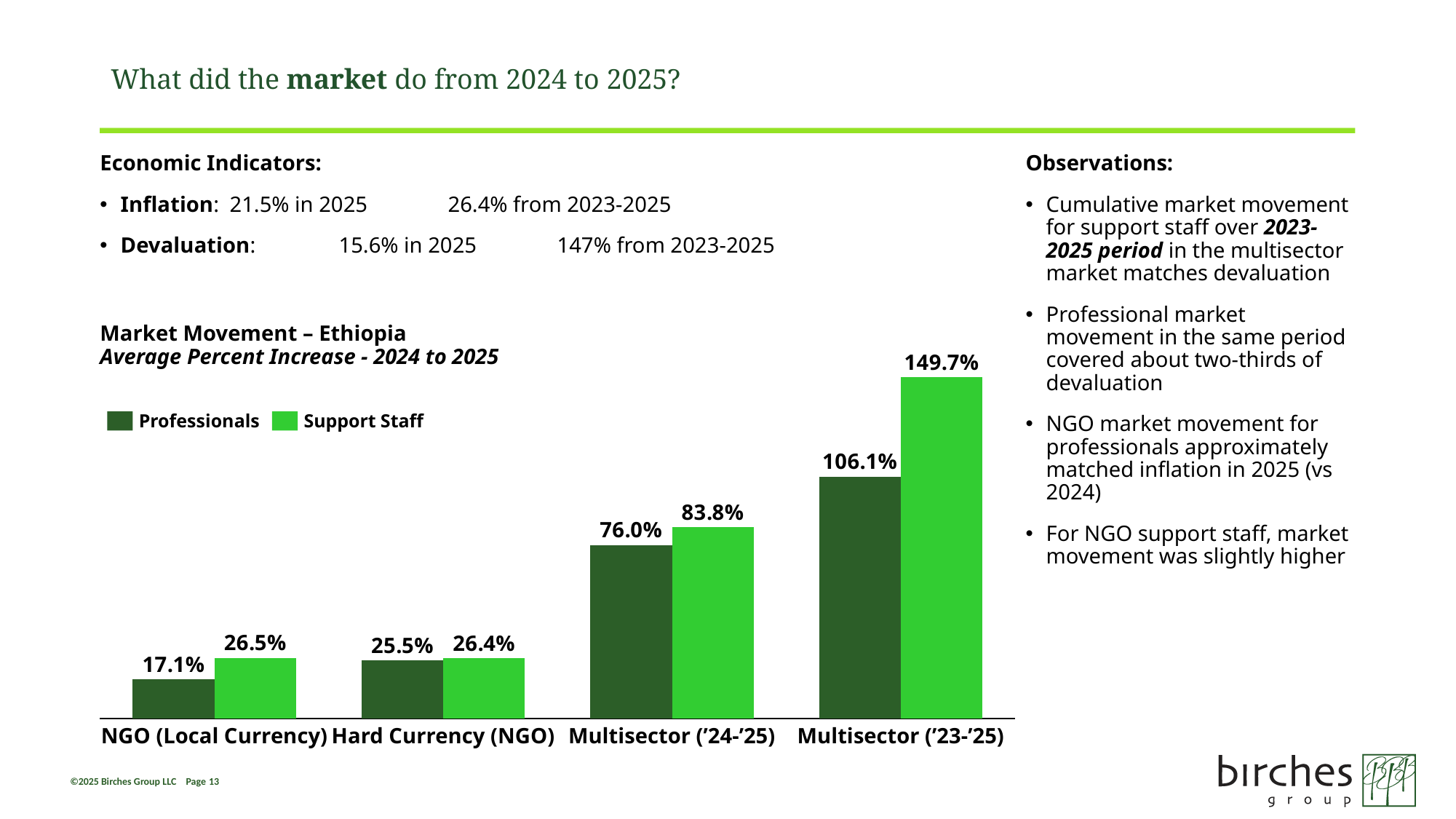
What is the Professionals value for NGO (Local Currency)? 17.1% How many categories are shown on the x axis? 4 What is the difference between the Support Staff and Professionals values for Multisector ('23-'25)? 43.6% Which category has the lowest Support Staff value? Hard Currency (NGO) What kind of chart is shown on the slide? Bar chart Which is larger for NGO (Local Currency): the Professionals value or the Support Staff value? Support Staff What is the Support Staff value for Multisector ('23-'25)? 149.7% What is the title of the chart? Market Movement – Ethiopia How many series does the legend list? 2 Which category has the highest Professionals value? Multisector ('23-'25) What is the Professionals value for Multisector ('24-'25)? 76.0% What is the Support Staff value for Hard Currency (NGO)? 26.4%